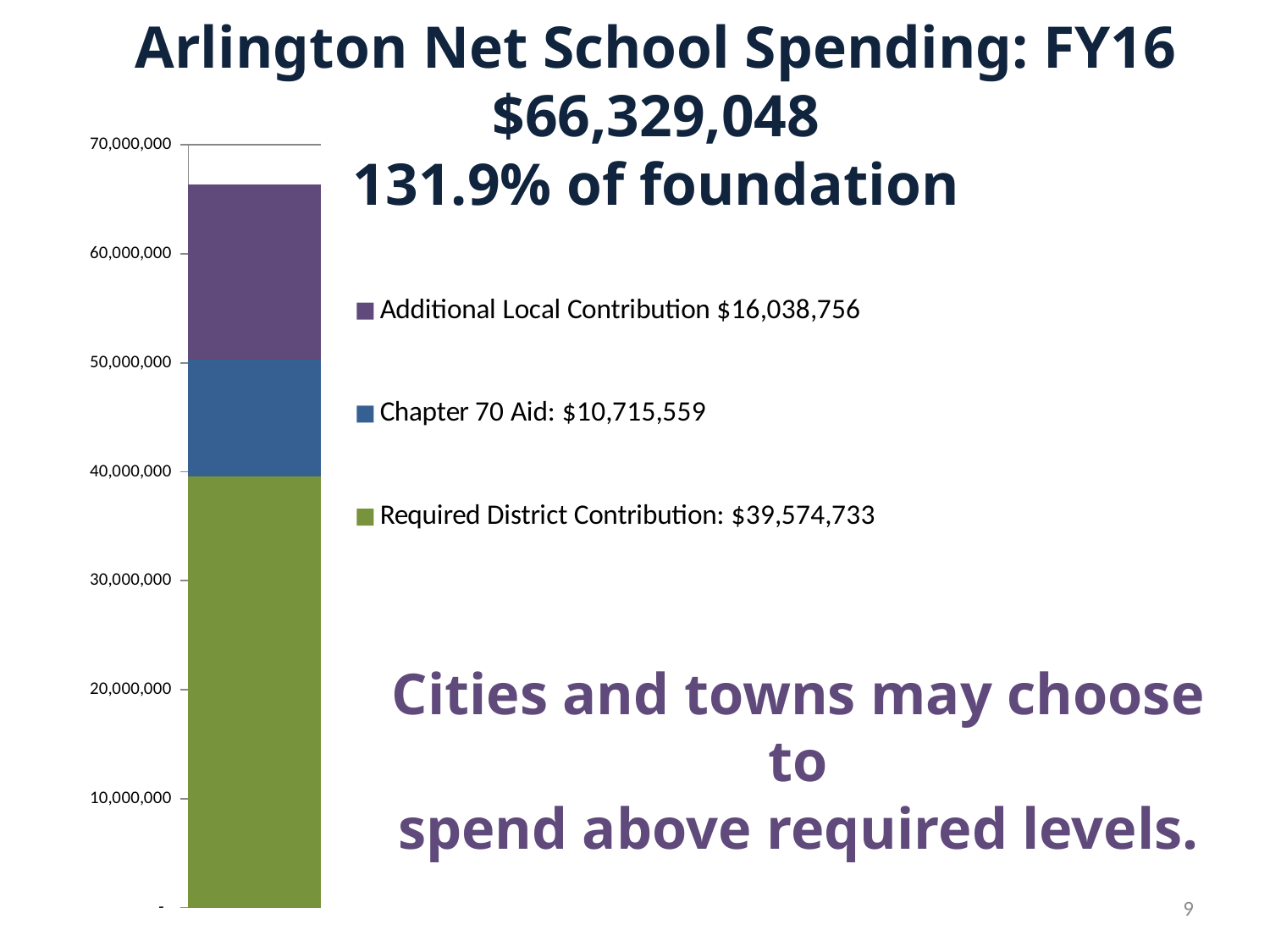
What is the value of the Additional Local Contribution? $16,038,756 What is the total of the stacked bar? $66,329,048 What is the value of Chapter 70 Aid? $10,715,559 Is the Required District Contribution greater or less than 40,000,000? less What kind of chart is shown on the slide? Stacked bar chart Which series has the largest value? Required District Contribution What is the difference between the Required District Contribution and Chapter 70 Aid? $28,859,174 Which colour represents Chapter 70 Aid in the chart? Blue How many series does the legend list? 3 Which is larger, the Additional Local Contribution or Chapter 70 Aid? Additional Local Contribution What is the value of the Required District Contribution? $39,574,733 Which series has the smallest value? Chapter 70 Aid